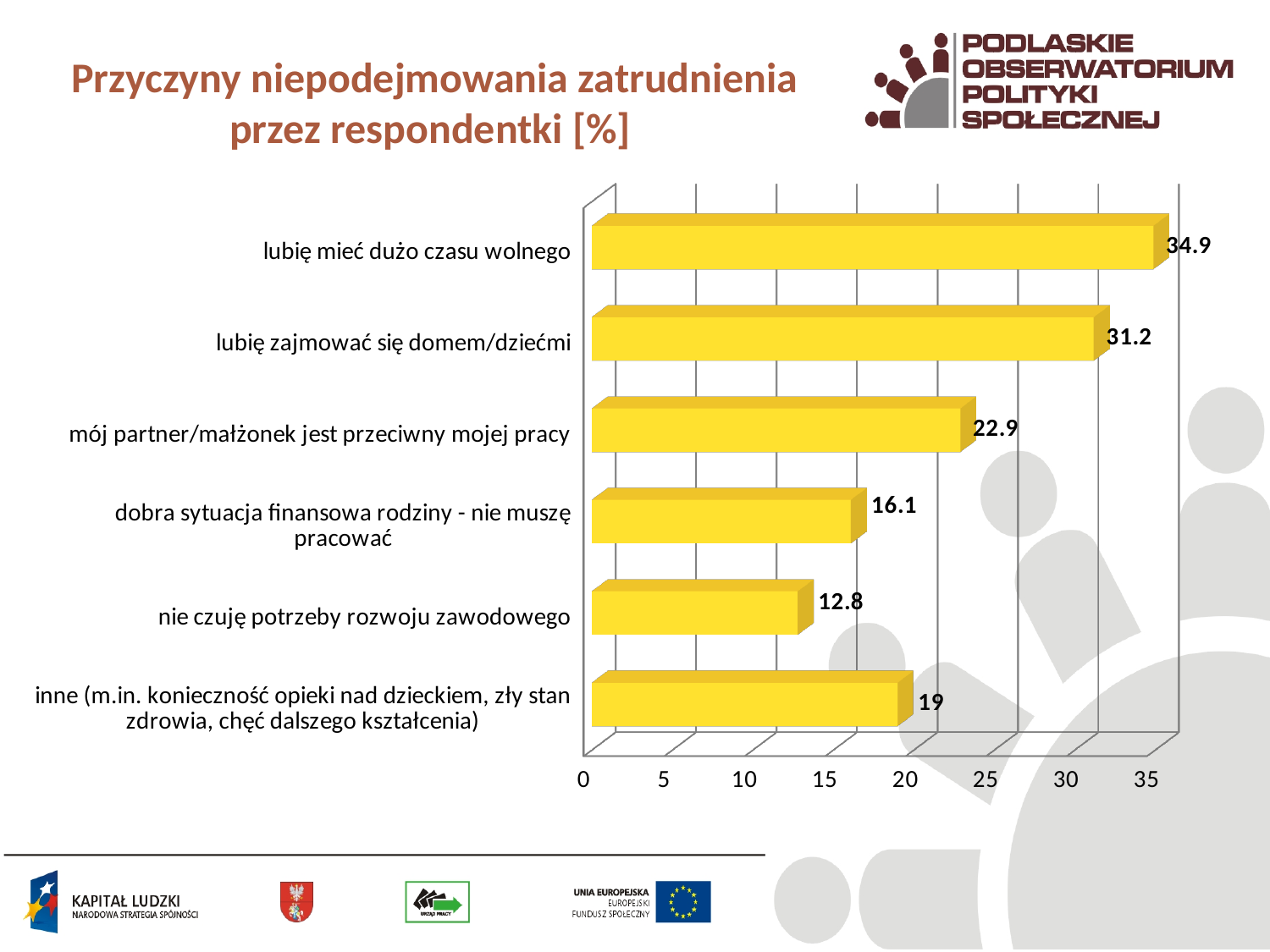
What is the value for "lubię mieć dużo czasu wolnego"? 34.9 Is the value for "lubię zajmować się domem/dziećmi" greater or less than 30? greater Which category has the highest value? lubię mieć dużo czasu wolnego What kind of chart is shown on the slide? bar chart What is the difference between the values for "mój partner/małżonek jest przeciwny mojej pracy" and "nie czuję potrzeby rozwoju zawodowego"? 10.1 How many categories are shown in the chart? 6 What is the difference between the values for "lubię mieć dużo czasu wolnego" and "lubię zajmować się domem/dziećmi"? 3.7 What is the value for "mój partner/małżonek jest przeciwny mojej pracy"? 22.9 Which category has the lowest value? nie czuję potrzeby rozwoju zawodowego What is the title of the chart on the slide? Przyczyny niepodejmowania zatrudnienia przez respondentki [%] What is the value for "nie czuję potrzeby rozwoju zawodowego"? 12.8 Which is larger: the value for "dobra sytuacja finansowa rodziny - nie muszę pracować" or the value for "inne (m.in. konieczność opieki nad dzieckiem, zły stan zdrowia, chęć dalszego kształcenia)"? inne (m.in. konieczność opieki nad dzieckiem, zły stan zdrowia, chęć dalszego kształcenia)